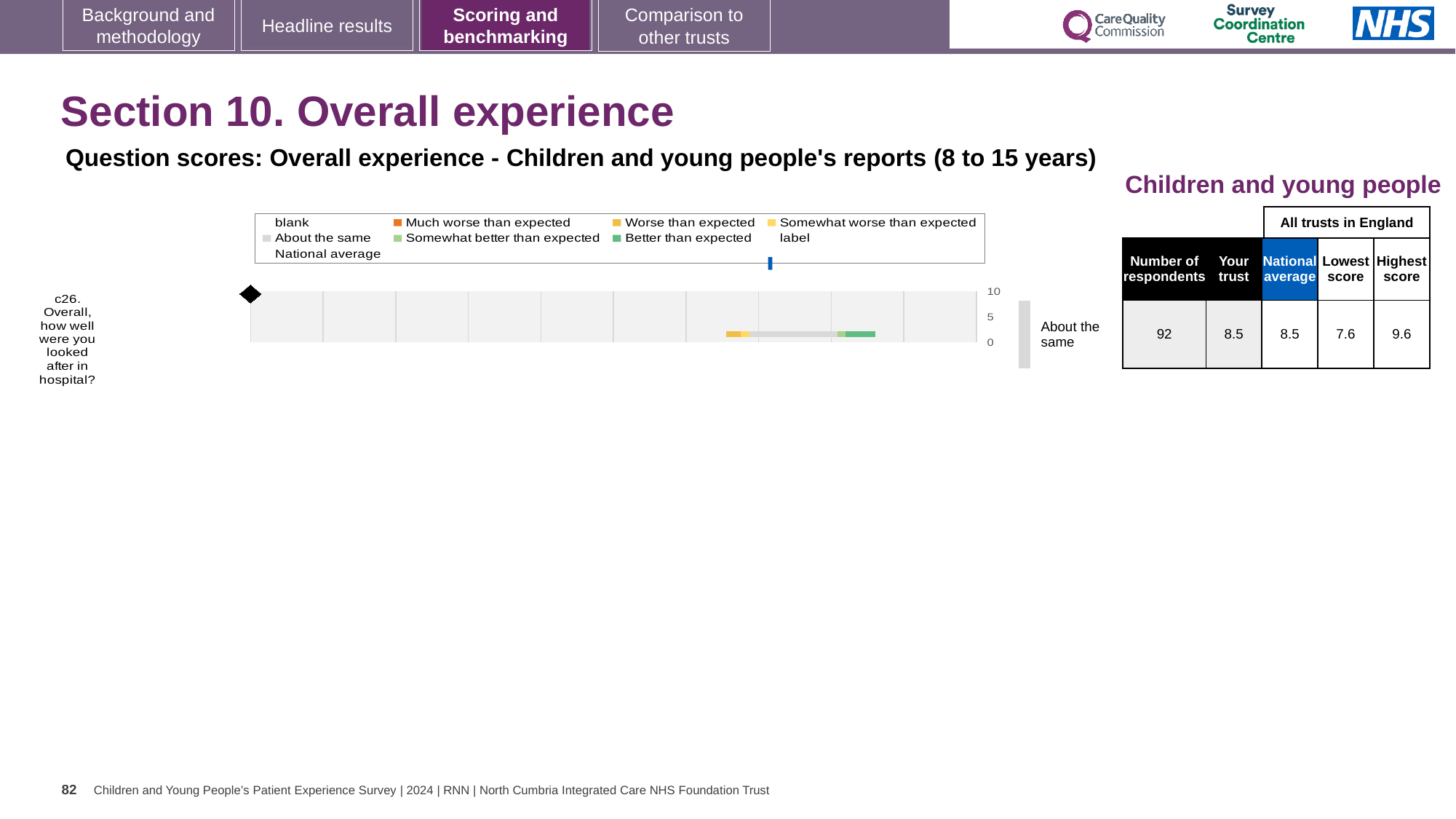
What is the question label shown on the chart? c26. Overall, how well were you looked after in hospital? How many questions are plotted on the chart? 1 What kind of chart is used to show the c26 question score? bar chart How many respondents answered question c26? 92 What is the trust's score for c26 'Overall, how well were you looked after in hospital?'? 8.5 Which is larger for c26: the highest score or the lowest score among all trusts in England? Highest score What is the highest value shown on the chart's score axis? 10 What is the highest score among all trusts in England for c26? 9.6 What is the lowest score among all trusts in England for c26? 7.6 What is the national average score for c26? 8.5 Is the trust's score for c26 greater or less than 5? greater What is the difference between the highest score and the lowest score for c26? 2.0